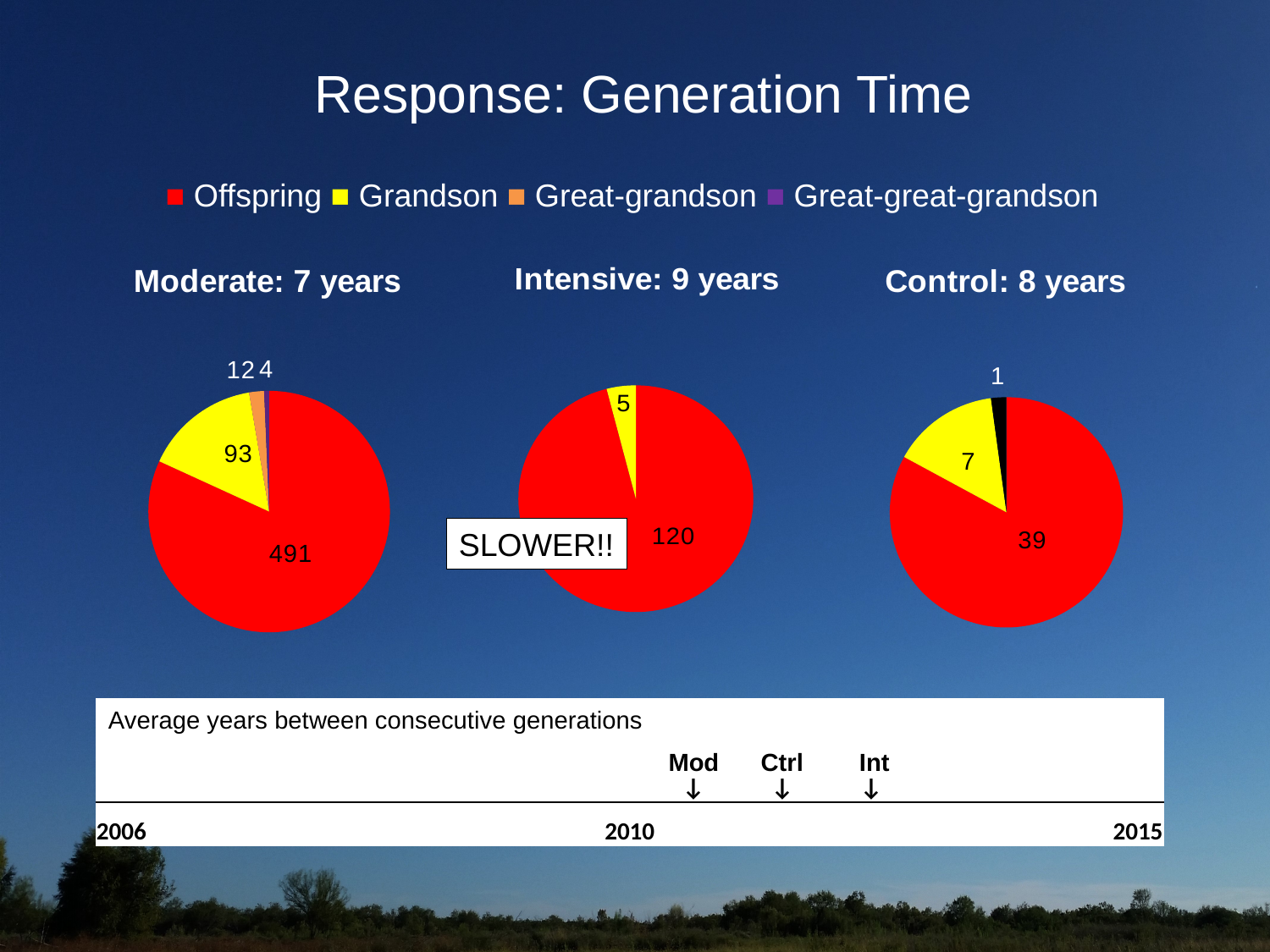
How many series does the legend list? 4 In the Intensive: 9 years pie chart, what share of the total does Offspring represent? 96% In the Control: 8 years pie chart, what is the total of all slices? 47 In the Moderate: 7 years pie chart, which category has the smallest slice? Great-great-grandson In the Moderate: 7 years pie chart, what is the value for Grandson? 93 In the Control: 8 years pie chart, what is the value for Grandson? 7 Which is larger: the Offspring value in the Intensive: 9 years pie chart or the Offspring value in the Control: 8 years pie chart? Intensive: 9 years In the Moderate: 7 years pie chart, what is the difference between the Offspring and Grandson values? 398 What type of charts are shown on the slide? Pie charts In the Intensive: 9 years pie chart, what is the value for Offspring? 120 In the Moderate: 7 years pie chart, what is the value for Offspring? 491 In the Moderate: 7 years pie chart, which category has the largest slice? Offspring